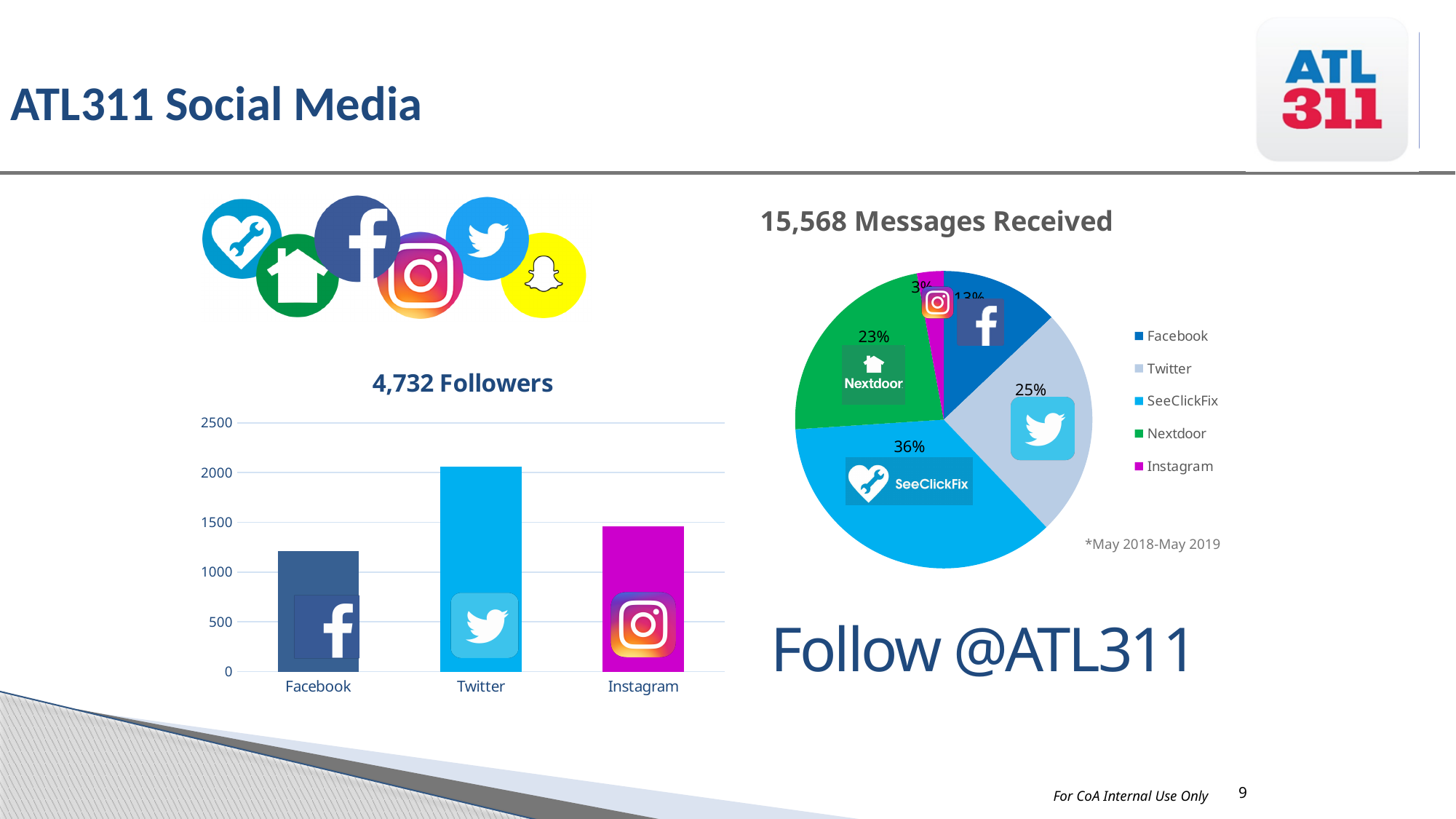
In the '4,732 Followers' chart, is the value for Twitter greater or less than 1500? greater In the '4,732 Followers' chart, which platform has the fewest followers? Facebook In the '15,568 Messages Received' pie chart, what share of messages came from SeeClickFix? 36% What kind of chart is the '15,568 Messages Received' chart? pie chart In the '4,732 Followers' chart, which platform has the most followers? Twitter In the '4,732 Followers' chart, how many platforms are shown? 3 What kind of chart is the '4,732 Followers' chart? bar chart In the '4,732 Followers' chart, is the value for Facebook greater or less than 1000? greater In the '15,568 Messages Received' pie chart, what is the difference between the Twitter share and the Instagram share? 22% In the '15,568 Messages Received' pie chart, what share of messages came from Nextdoor? 23% How many entries does the legend of the '15,568 Messages Received' pie chart list? 5 In the '15,568 Messages Received' pie chart, which platform has the smallest share? Instagram